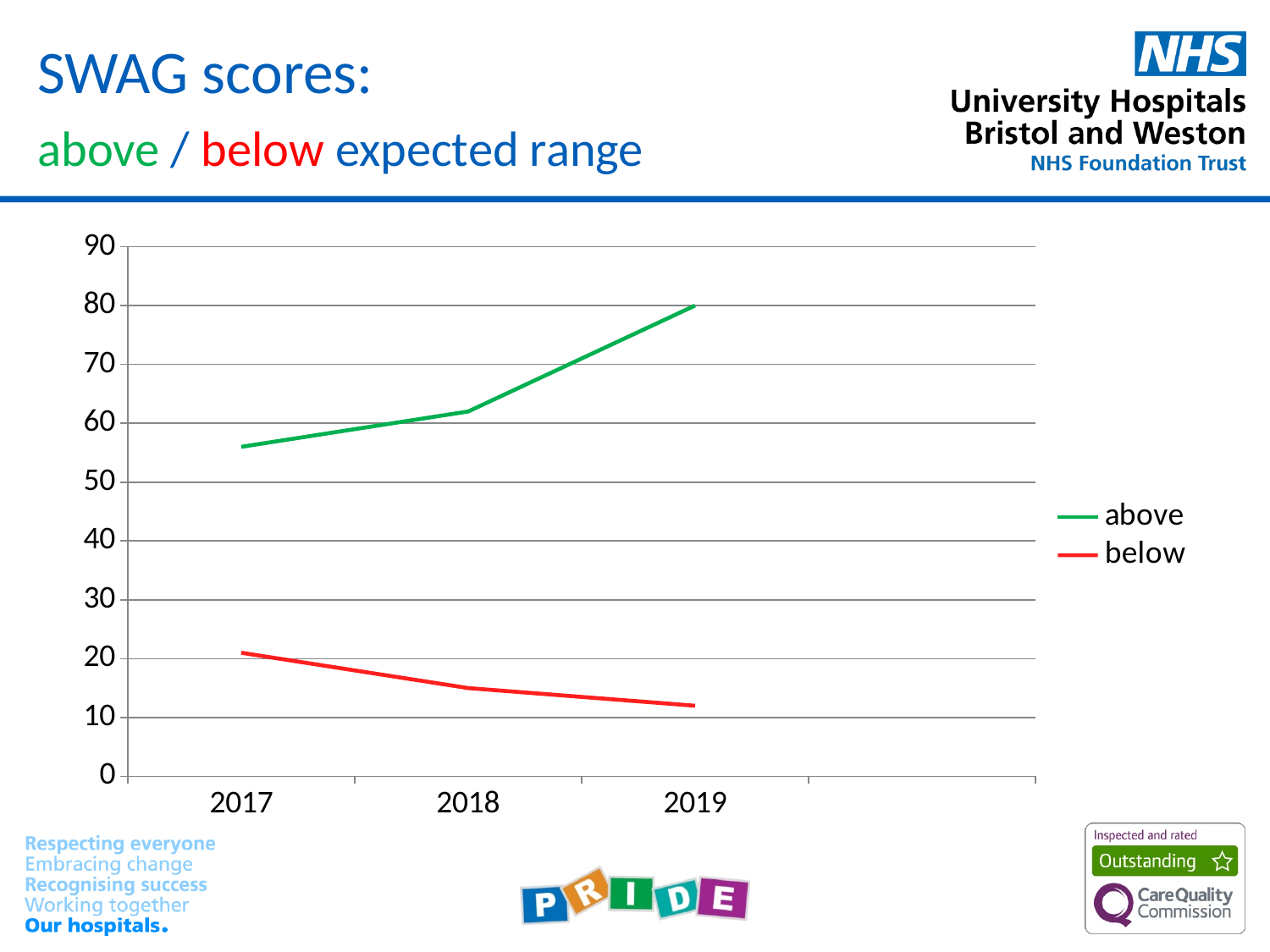
Does the 'above' series rise or fall from 2017 to 2019? rise How many series does the legend list? 2 Is the value for 'above' in 2018 greater or less than 70? less What kind of chart is shown on the slide? line chart In which year is the 'above' series at its highest? 2019 Is the value for 'below' in 2017 greater or less than 30? less Is the value for 'above' in 2017 greater or less than 50? greater How many years are shown on the x axis? 3 In 2019, which series has the larger value, 'above' or 'below'? above Does the 'below' series rise or fall from 2017 to 2019? fall What colour is the line for the 'below' series? red